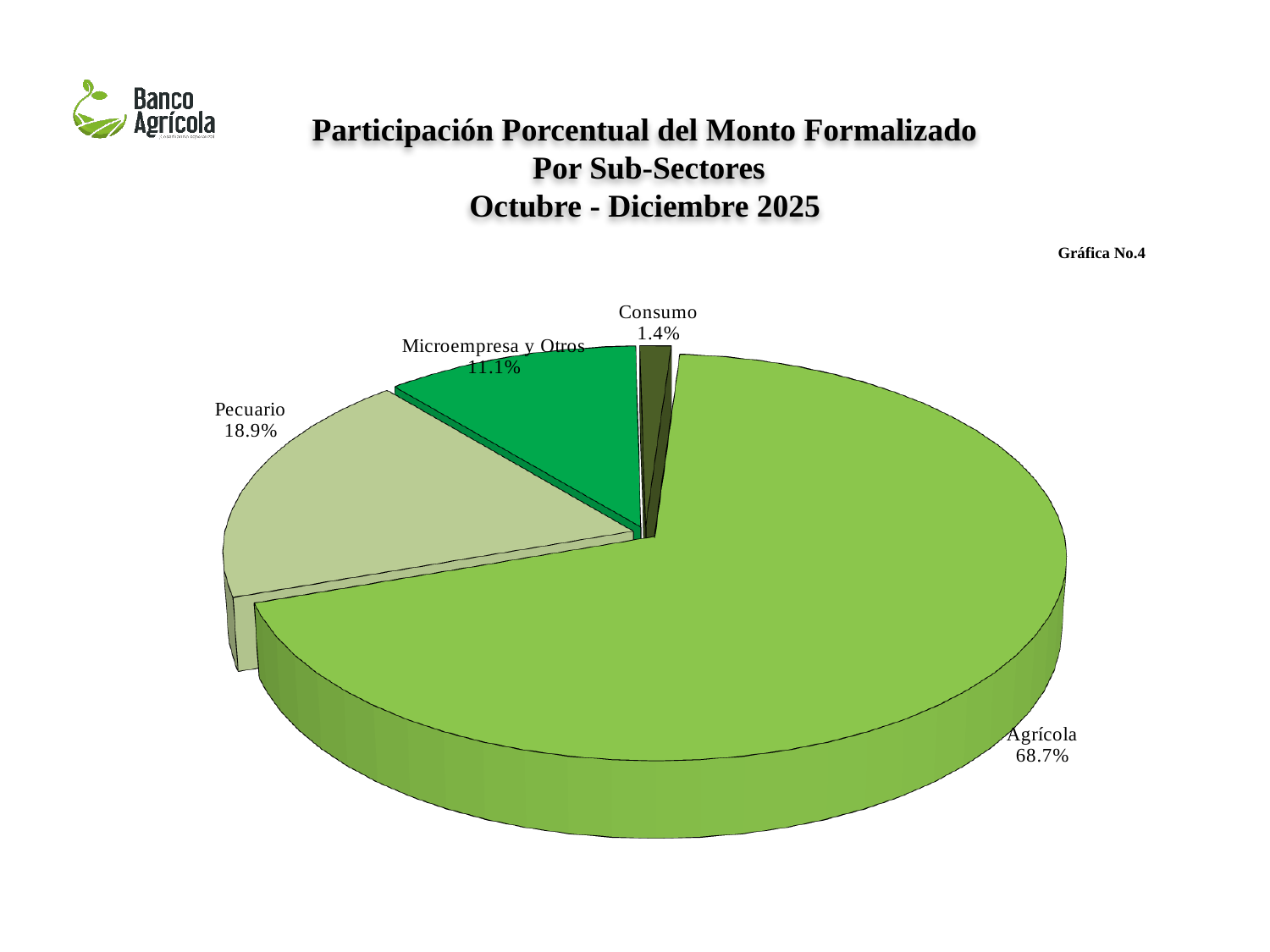
Which sub-sector has the smallest share of the pie? Consumo What is the title of the chart? Participación Porcentual del Monto Formalizado Por Sub-Sectores Octubre - Diciembre 2025 What is the value shown for Pecuario? 18.9% What is the value shown for Microempresa y Otros? 11.1% What is the difference in percentage points between Pecuario and Microempresa y Otros? 7.8 What is the value shown for Consumo? 1.4% What kind of chart is shown on the slide? Pie chart Which sub-sector has the largest share of the pie? Agrícola Which is larger, the share for Pecuario or the share for Microempresa y Otros? Pecuario How many sub-sectors are shown in the pie chart? 4 What share of the pie does Agrícola hold? 68.7% What is the difference in percentage points between Agrícola and Pecuario? 49.8